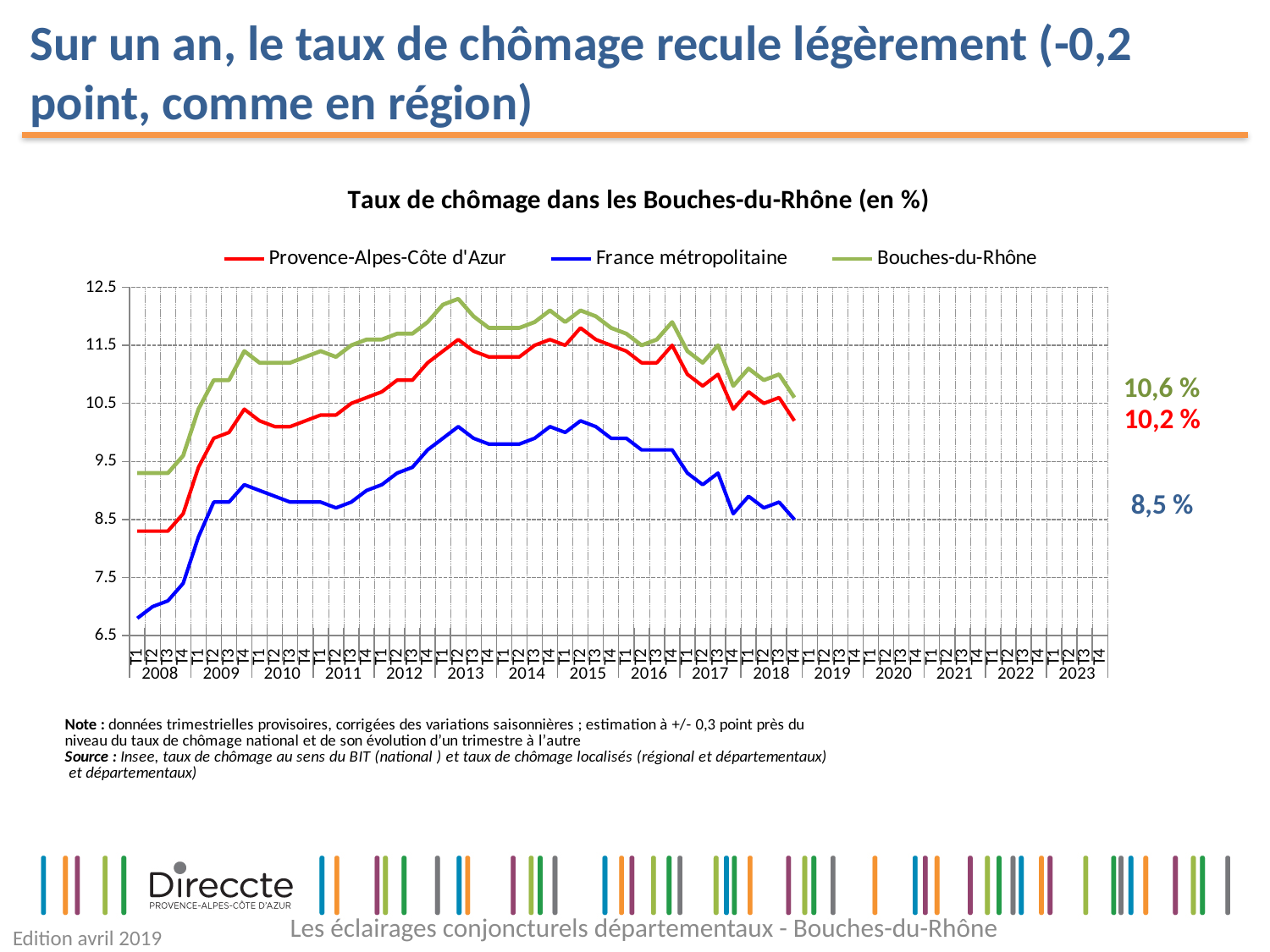
Which series has the lowest latest value? France métropolitaine Which series has the highest latest value? Bouches-du-Rhône What is the latest value shown for Bouches-du-Rhône? 10,6 % Is the value for France métropolitaine in T1 2008 greater or less than 7.5? less What is the latest value shown for France métropolitaine? 8,5 % What is the title of the chart? Taux de chômage dans les Bouches-du-Rhône (en %) How many series does the legend list? 3 What is the latest value shown for Provence-Alpes-Côte d'Azur? 10,2 % What is the difference between the latest values for Bouches-du-Rhône and France métropolitaine? 2,1 points What kind of chart is shown on the slide? line chart Does the France métropolitaine line rise or fall between 2008 and 2013? rise Is the value for Bouches-du-Rhône in T2 2013 greater or less than 12? greater